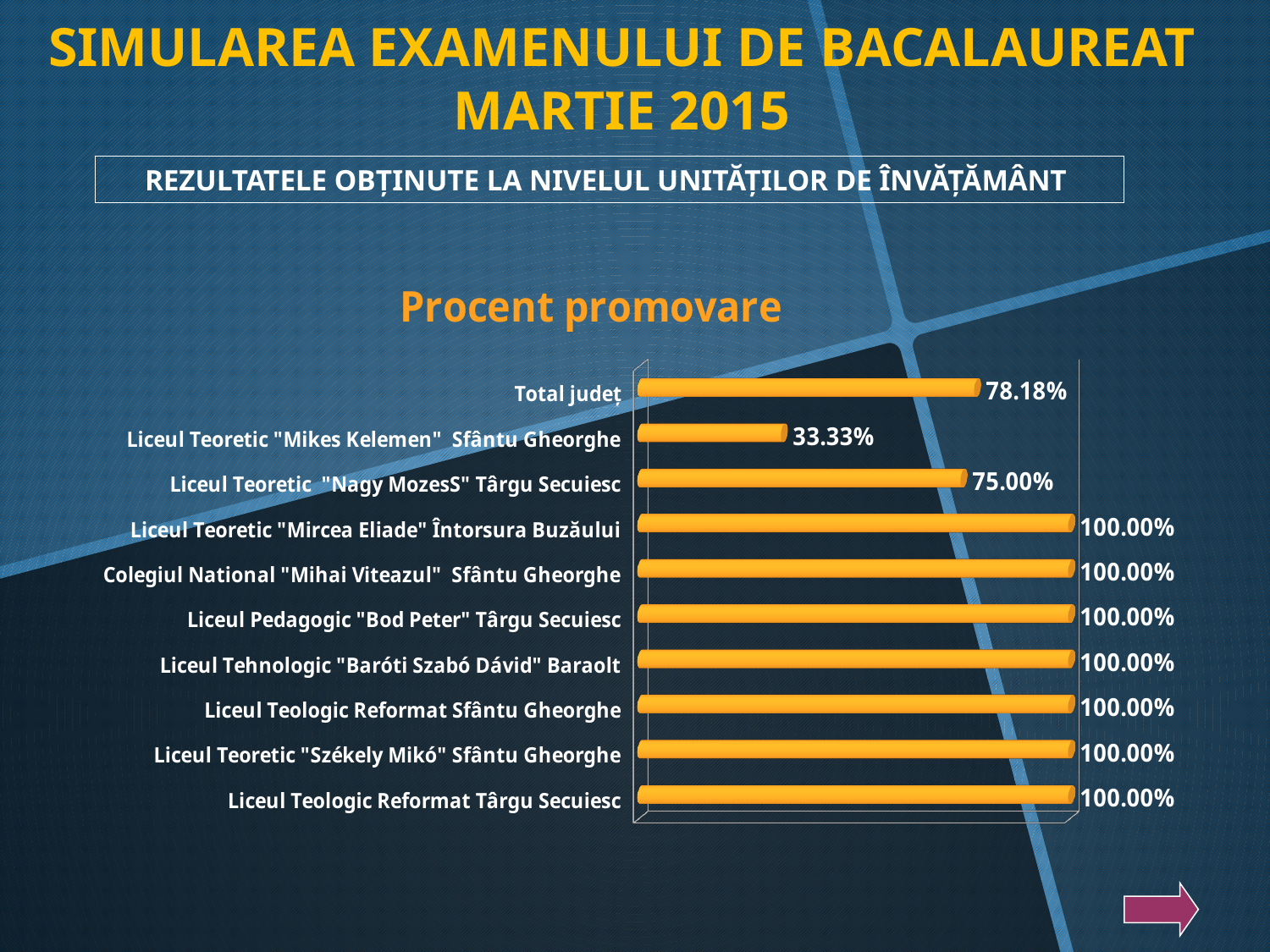
What is the value for Liceul Teoretic "Nagy MozesS" Târgu Secuiesc? 75.00% What is the value for Liceul Teoretic "Mikes Kelemen" Sfântu Gheorghe? 33.33% What is the difference between the value for Total județ and the value for Liceul Teoretic "Mikes Kelemen" Sfântu Gheorghe? 44.85% What is the value for Liceul Pedagogic "Bod Peter" Târgu Secuiesc? 100.00% What kind of chart is shown on the slide? Bar chart How many categories are shown in the chart? 10 What is the title of the chart? Procent promovare What is the difference between the value for Liceul Teoretic "Nagy MozesS" Târgu Secuiesc and the value for Liceul Teoretic "Mikes Kelemen" Sfântu Gheorghe? 41.67% Which category has the lowest value? Liceul Teoretic "Mikes Kelemen" Sfântu Gheorghe What is the value for Total județ? 78.18% How many categories have a value of 100.00%? 7 Which is larger, the value for Total județ or the value for Liceul Teoretic "Nagy MozesS" Târgu Secuiesc? Total județ